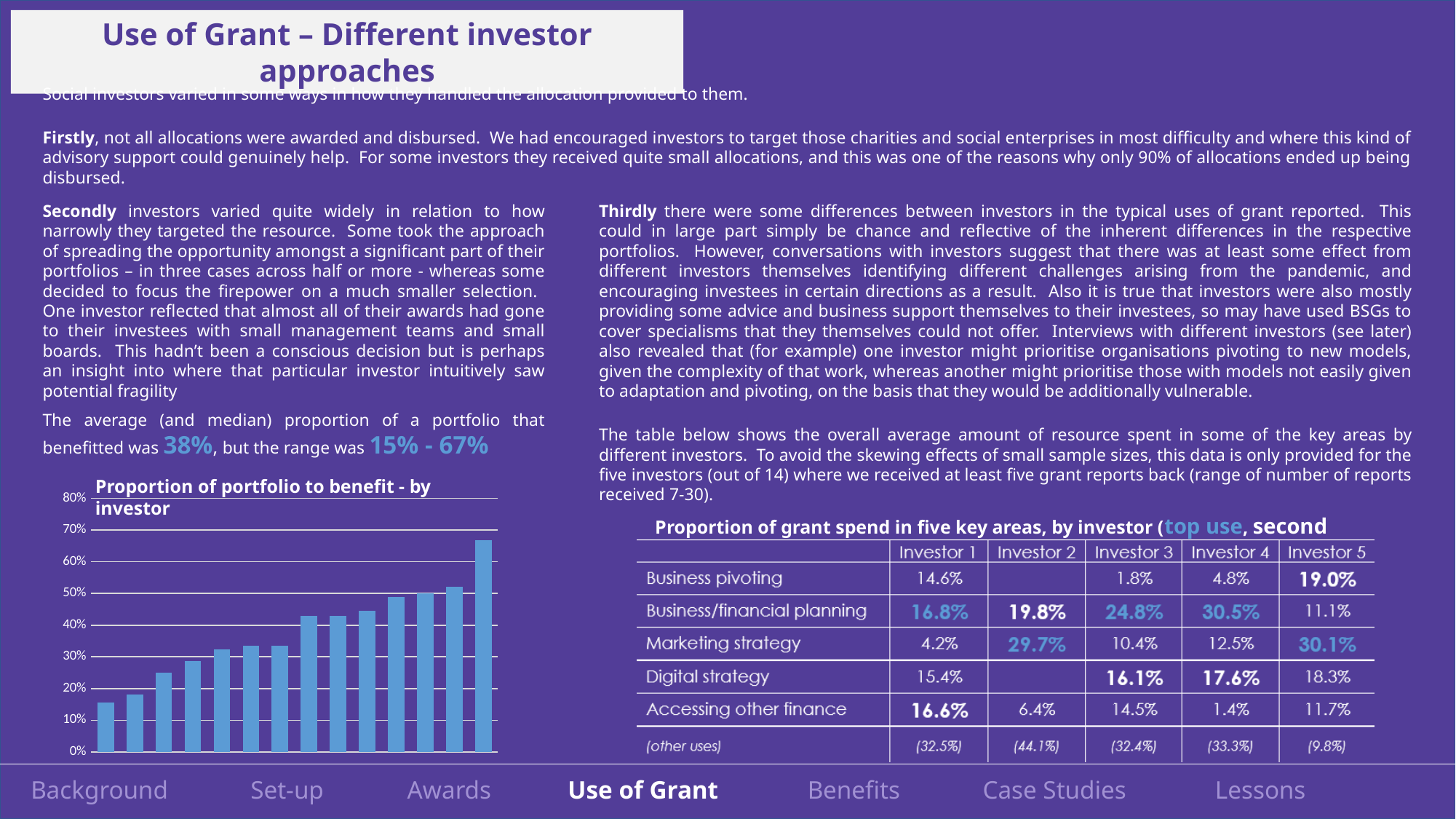
In the 'Proportion of portfolio to benefit - by investor' chart, is the value of the tallest (rightmost) bar greater or less than 60%? greater In the 'Proportion of portfolio to benefit - by investor' chart, is the value of the third bar from the left greater or less than 30%? less In the 'Proportion of portfolio to benefit - by investor' chart, which bar is taller: the leftmost bar or the rightmost bar? the rightmost bar In the 'Proportion of portfolio to benefit - by investor' chart, is the value of the second bar from the right greater or less than 50%? greater In the 'Proportion of portfolio to benefit - by investor' chart, do the bar values rise or fall from left to right? rise What is the title of the bar chart on the slide? Proportion of portfolio to benefit - by investor How many bars are plotted in the 'Proportion of portfolio to benefit - by investor' chart? 14 What kind of chart is 'Proportion of portfolio to benefit - by investor'? bar chart What is the highest value shown on the y-axis of the 'Proportion of portfolio to benefit - by investor' chart? 80%